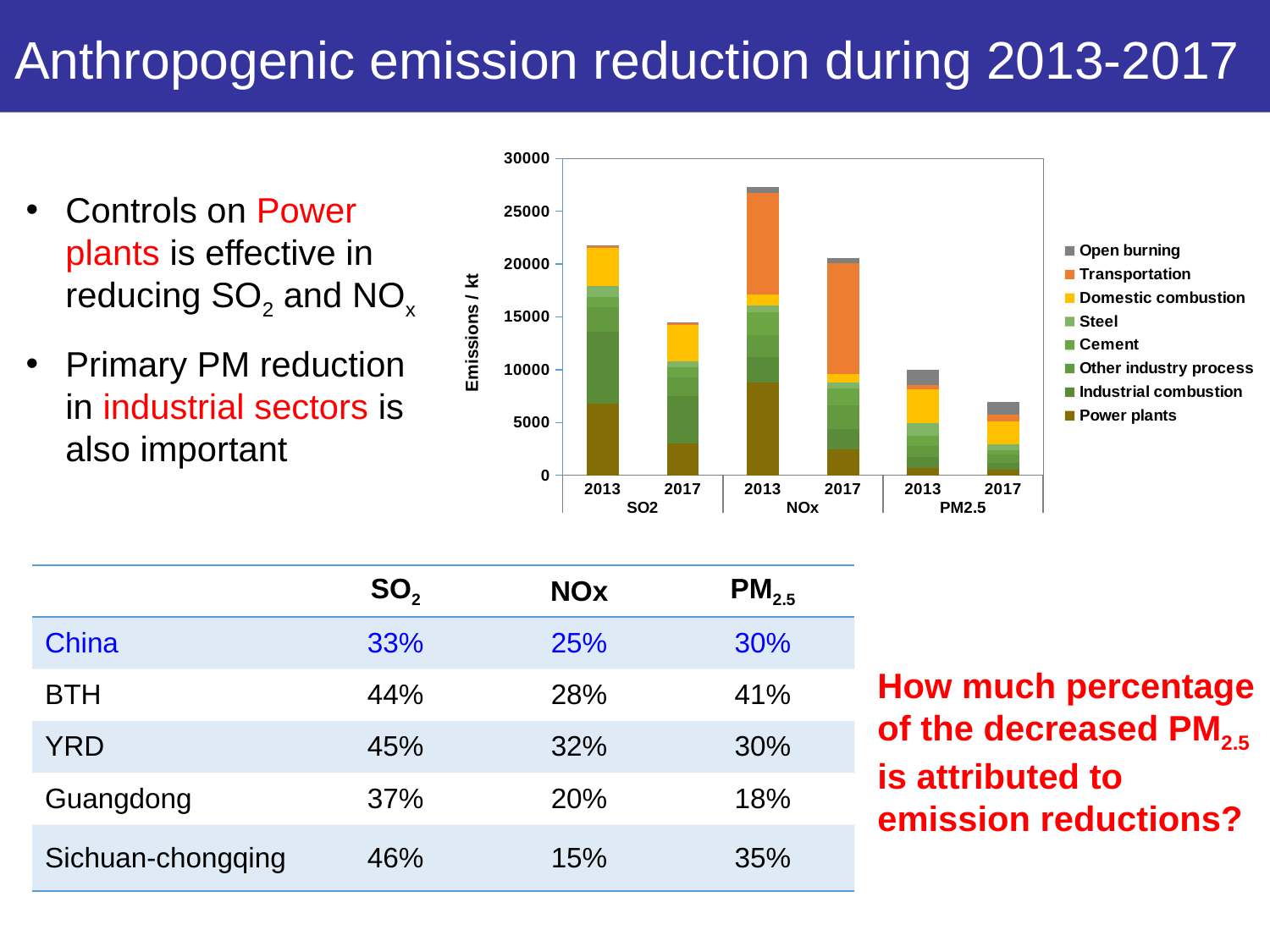
Is the total emissions value for SO2 in 2017 greater or less than 15000? less For each pollutant in the chart, do total emissions rise or fall from 2013 to 2017? fall Which bar in the chart has the lowest total emissions? PM2.5 2017 Is the total emissions value for PM2.5 in 2017 greater or less than 10000? less Which bar in the chart has the highest total emissions? NOx 2013 What kind of chart is shown on the slide? stacked bar chart Is the total emissions value for SO2 in 2013 greater or less than 20000? greater What is the label on the chart's vertical axis? Emissions / kt How many series does the chart's legend list? 8 How many bars are plotted in the chart? 6 Which is larger in the chart, total NOx emissions in 2013 or in 2017? 2013